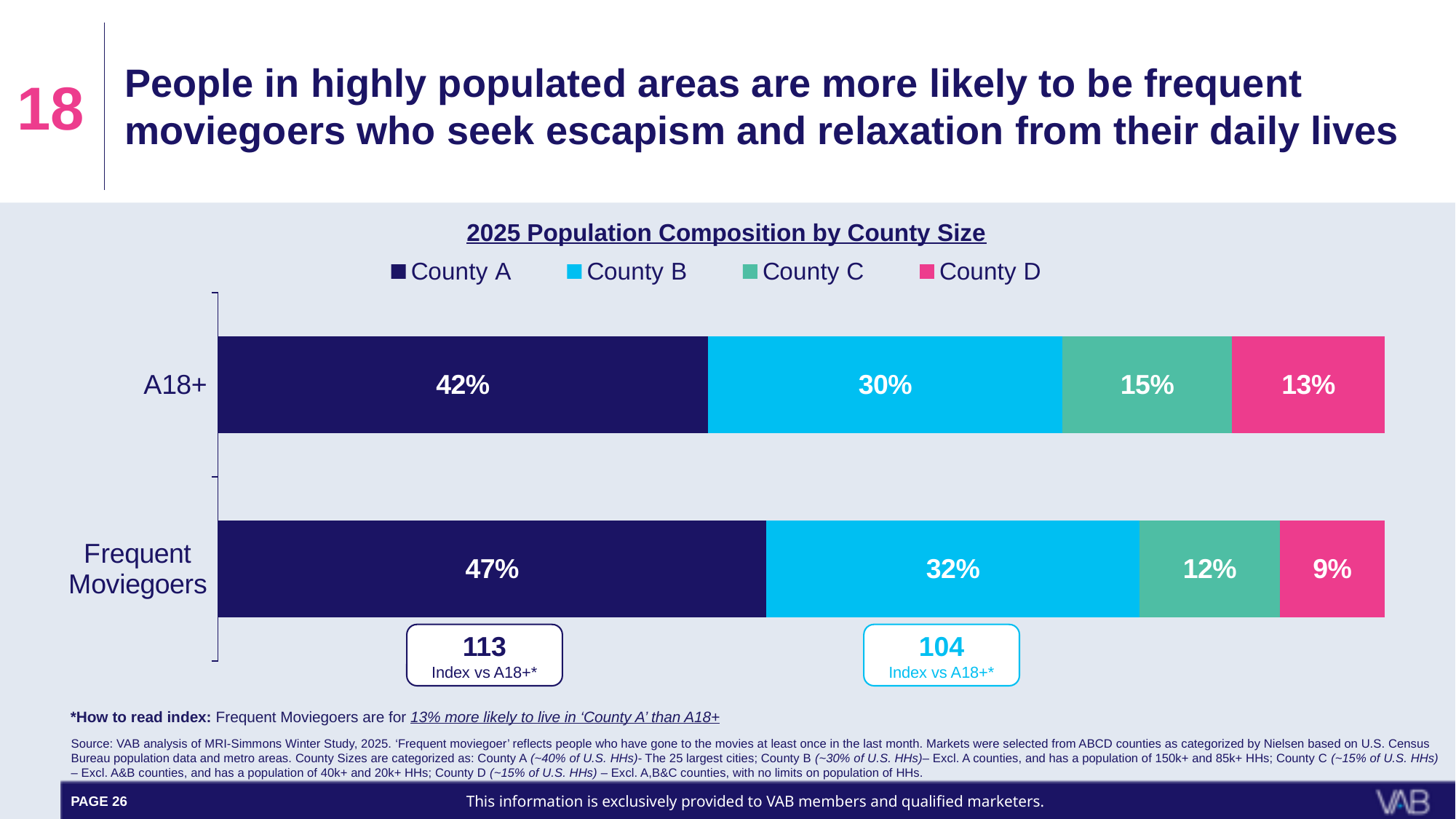
Which county has the smallest share among A18+? County D How many series does the legend list? 4 How many categories (bars) are shown on the chart? 2 What is the County D share for A18+? 13% What is the title of the chart? 2025 Population Composition by County Size What is the difference between the County A share for Frequent Moviegoers and for A18+? 5% What is the County B share for A18+? 30% What kind of chart is shown? Stacked bar chart Which is larger: the County D share for A18+ or for Frequent Moviegoers? A18+ Which county has the largest share among Frequent Moviegoers? County A What is the County A share for Frequent Moviegoers? 47% What is the County C share for Frequent Moviegoers? 12%